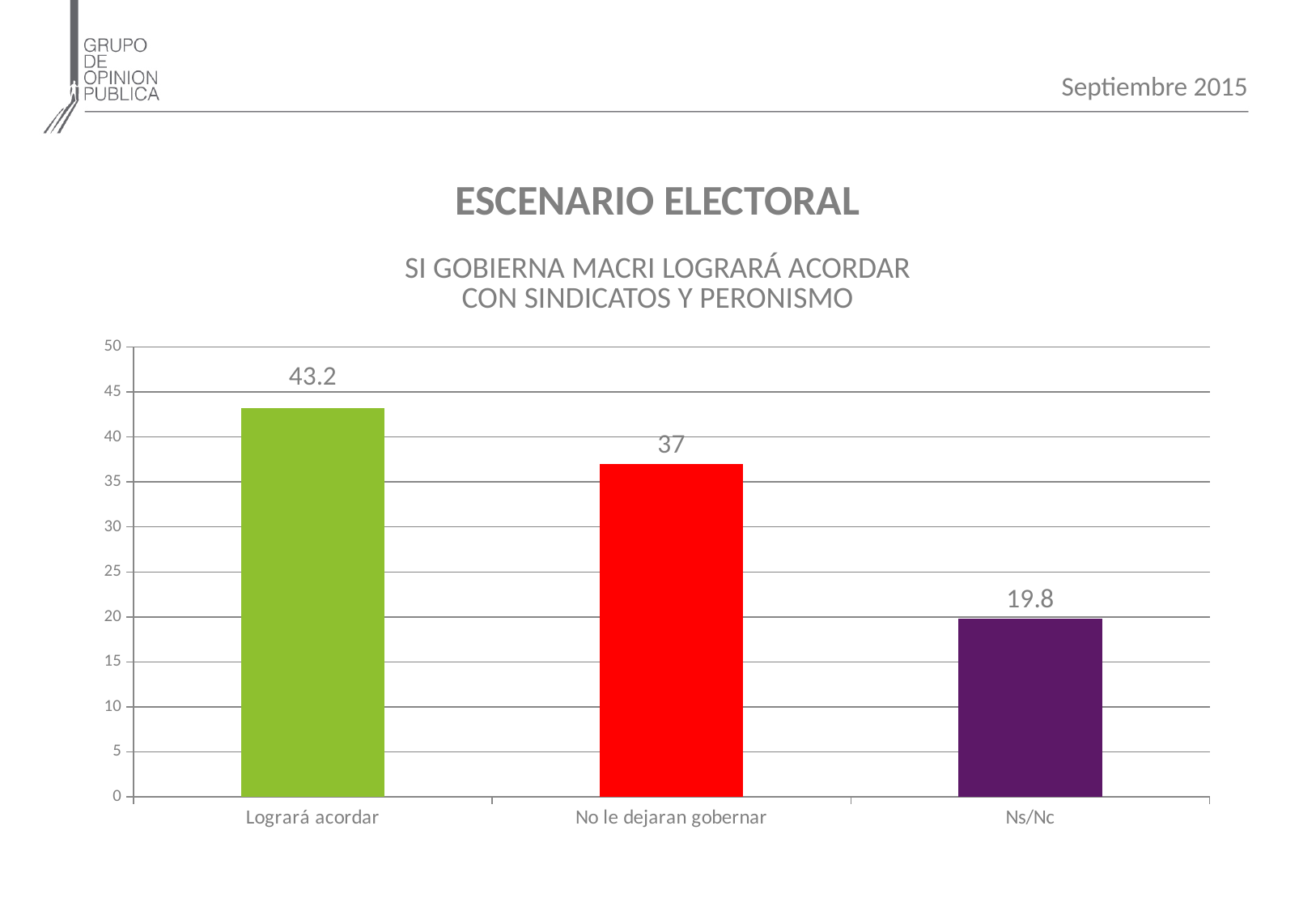
What is the value for "Ns/Nc"? 19.8 Is the value for "Ns/Nc" greater or less than 20? less What is the difference between the values for "Logrará acordar" and "No le dejaran gobernar"? 6.2 What kind of chart is shown on the slide? Bar chart Which category has the lowest value? Ns/Nc What colour is the bar for "No le dejaran gobernar"? Red What is the value for "Logrará acordar"? 43.2 What is the difference between the values for "No le dejaran gobernar" and "Ns/Nc"? 17.2 Which is larger, the value for "No le dejaran gobernar" or the value for "Ns/Nc"? No le dejaran gobernar What is the value for "No le dejaran gobernar"? 37 Which category has the highest value? Logrará acordar How many categories are shown on the x axis? 3